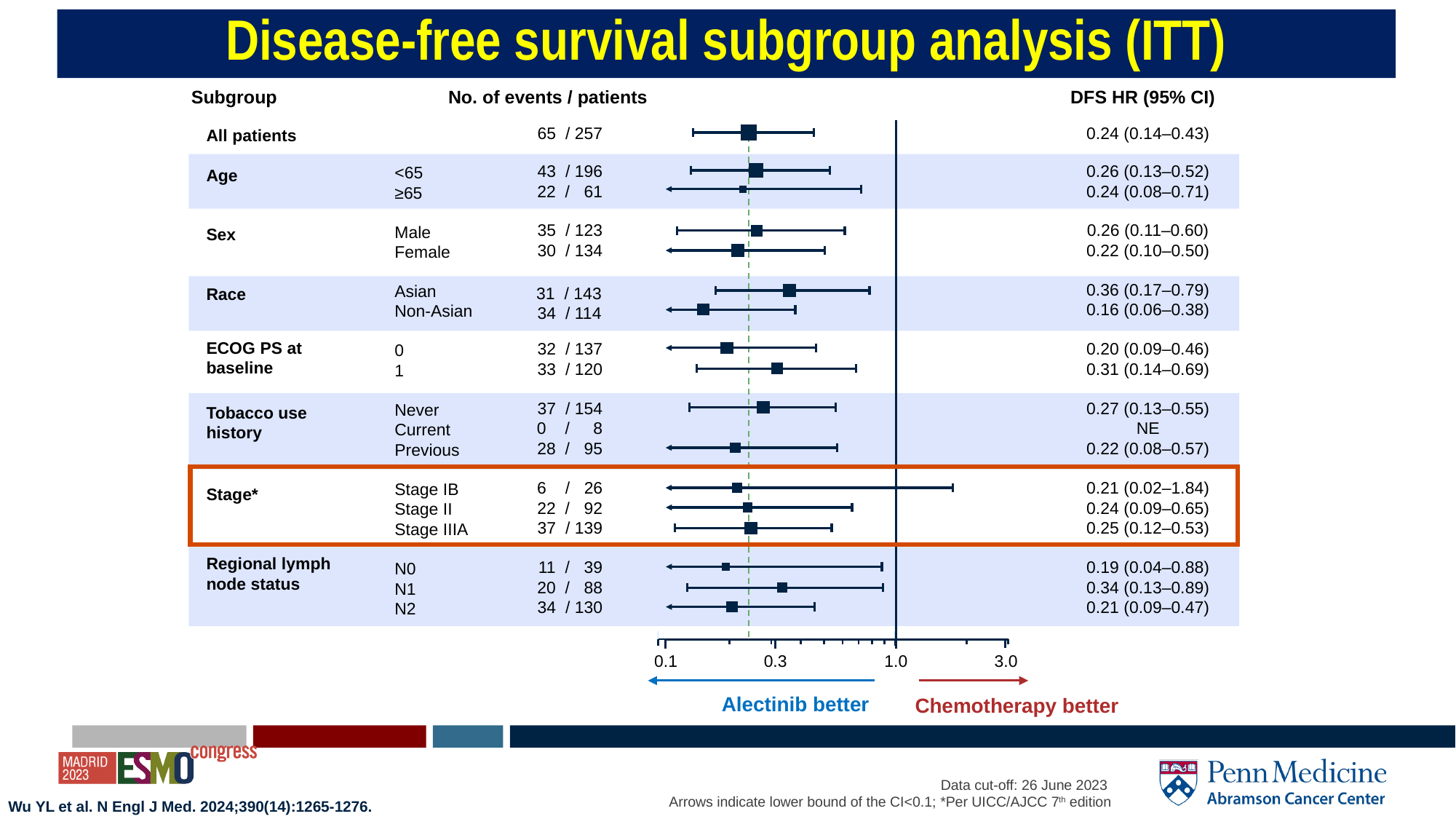
Which subgroup has the lowest DFS hazard ratio point estimate? Non-Asian What kind of chart is shown on the slide? Forest plot What is the difference between the DFS HR point estimates for the Asian and Non-Asian subgroups? 0.20 How many Stage subgroups are plotted inside the highlighted box? 3 How many events / patients are listed for the Stage IIIA subgroup? 37 / 139 What is the DFS HR shown for the Current tobacco use subgroup? NE What is the DFS HR (95% CI) for the Asian race subgroup? 0.36 (0.17–0.79) What is the DFS HR (95% CI) for All patients? 0.24 (0.14–0.43) Which has the larger DFS HR point estimate, the N1 or the N0 lymph node status subgroup? N1 Is the DFS HR for All patients greater or less than 1.0? less Which subgroup has the highest DFS hazard ratio point estimate? Asian Which treatment is labelled as better on the left side of the x axis? Alectinib